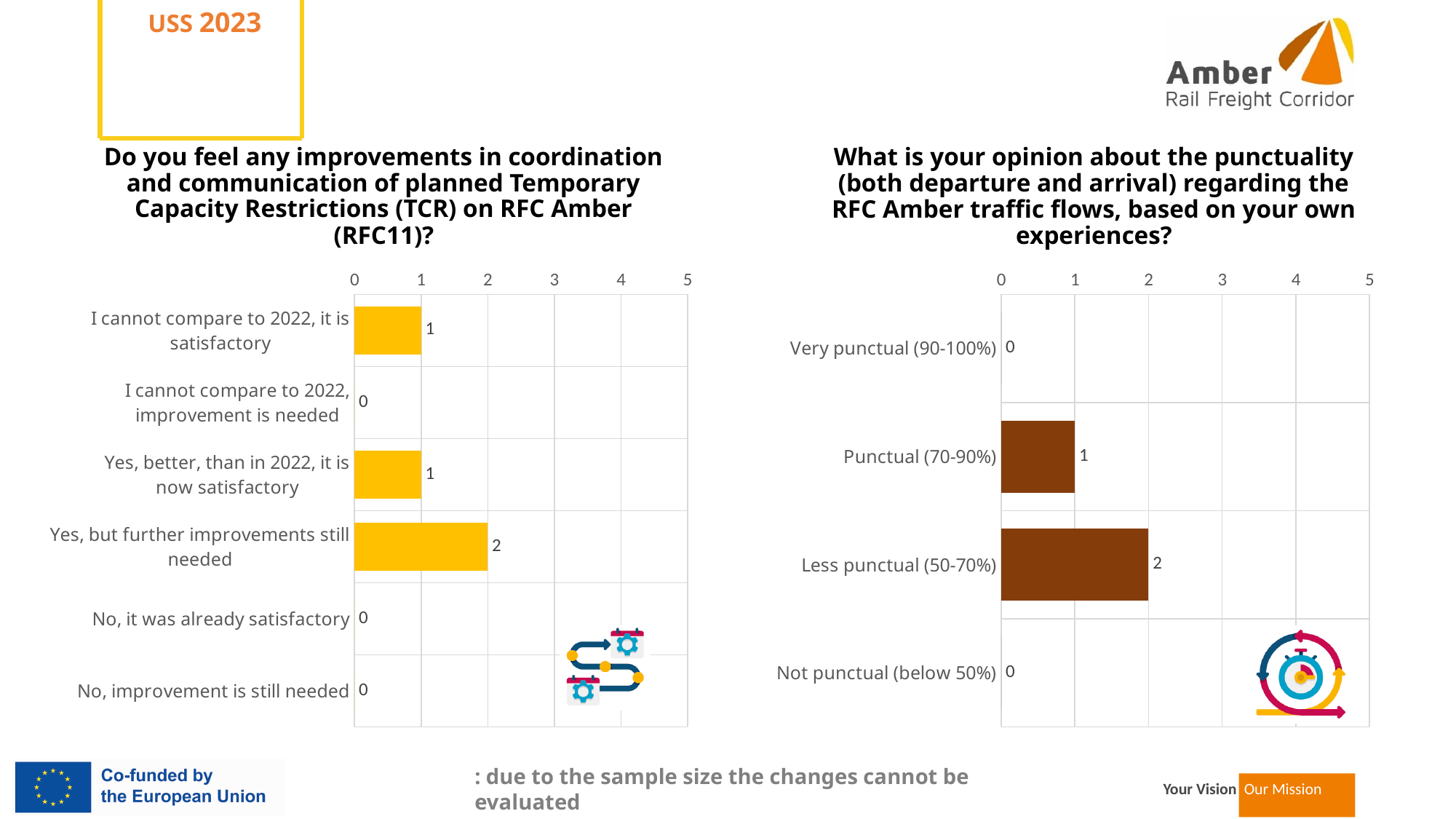
In the left chart about improvements in coordination and communication of planned TCR, what is the value for 'I cannot compare to 2022, it is satisfactory'? 1 What kind of chart is the left chart about improvements in coordination and communication of planned TCR? Bar chart In the right chart about punctuality of RFC Amber traffic flows, how many categories are shown? 4 In the left chart about improvements in coordination and communication of planned TCR, what is the value for 'Yes, but further improvements still needed'? 2 In the right chart about punctuality of RFC Amber traffic flows, which is larger: 'Punctual (70-90%)' or 'Less punctual (50-70%)'? Less punctual (50-70%) In the left chart about improvements in coordination and communication of planned TCR, how many categories are shown? 6 In the left chart about improvements in coordination and communication of planned TCR, what is the difference between 'Yes, but further improvements still needed' and 'Yes, better, than in 2022, it is now satisfactory'? 1 In the right chart about punctuality of RFC Amber traffic flows, which category has the highest value? Less punctual (50-70%) In the right chart about punctuality of RFC Amber traffic flows, what is the value for 'Less punctual (50-70%)'? 2 In the right chart about punctuality of RFC Amber traffic flows, what is the value for 'Very punctual (90-100%)'? 0 In the right chart about punctuality of RFC Amber traffic flows, what is the value for 'Punctual (70-90%)'? 1 In the left chart about improvements in coordination and communication of planned TCR, which category has the highest value? Yes, but further improvements still needed